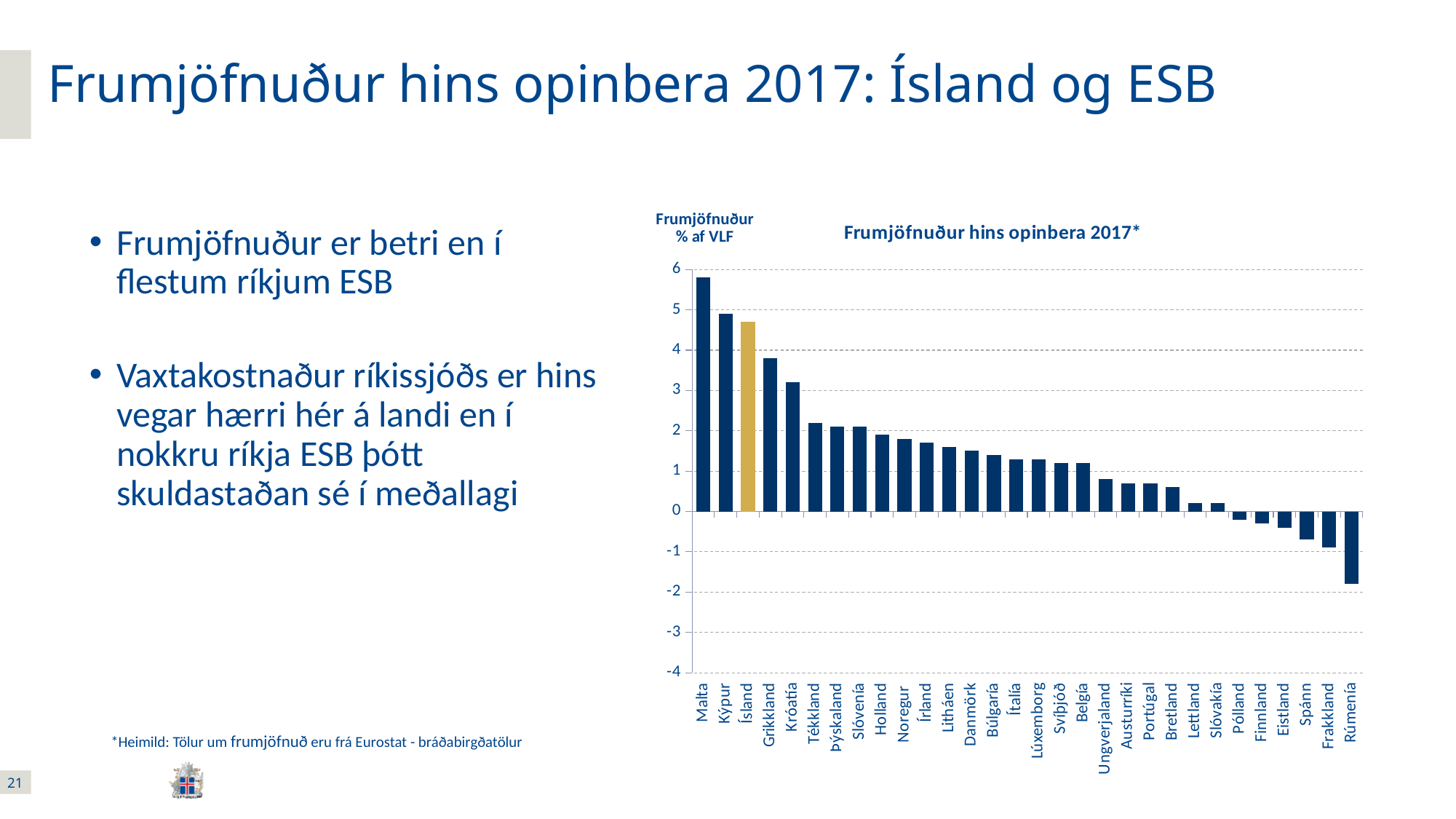
Which has the larger value, Frakkland or Rúmenía? Frakkland Is the value for Ungverjaland greater or less than 1? less Is the value for Ísland greater or less than 4? greater What kind of chart is shown on the slide? bar chart Which country has the lowest value in the chart? Rúmenía Which has the larger value, Ísland or Grikkland? Ísland How many countries are shown on the x axis of the chart? 30 Which country has the highest value in the chart? Malta Is the value for Malta greater or less than 5? greater Which country's bar is shown in a different (gold) colour from the others? Ísland Do the values rise or fall moving from left to right along the x axis? fall